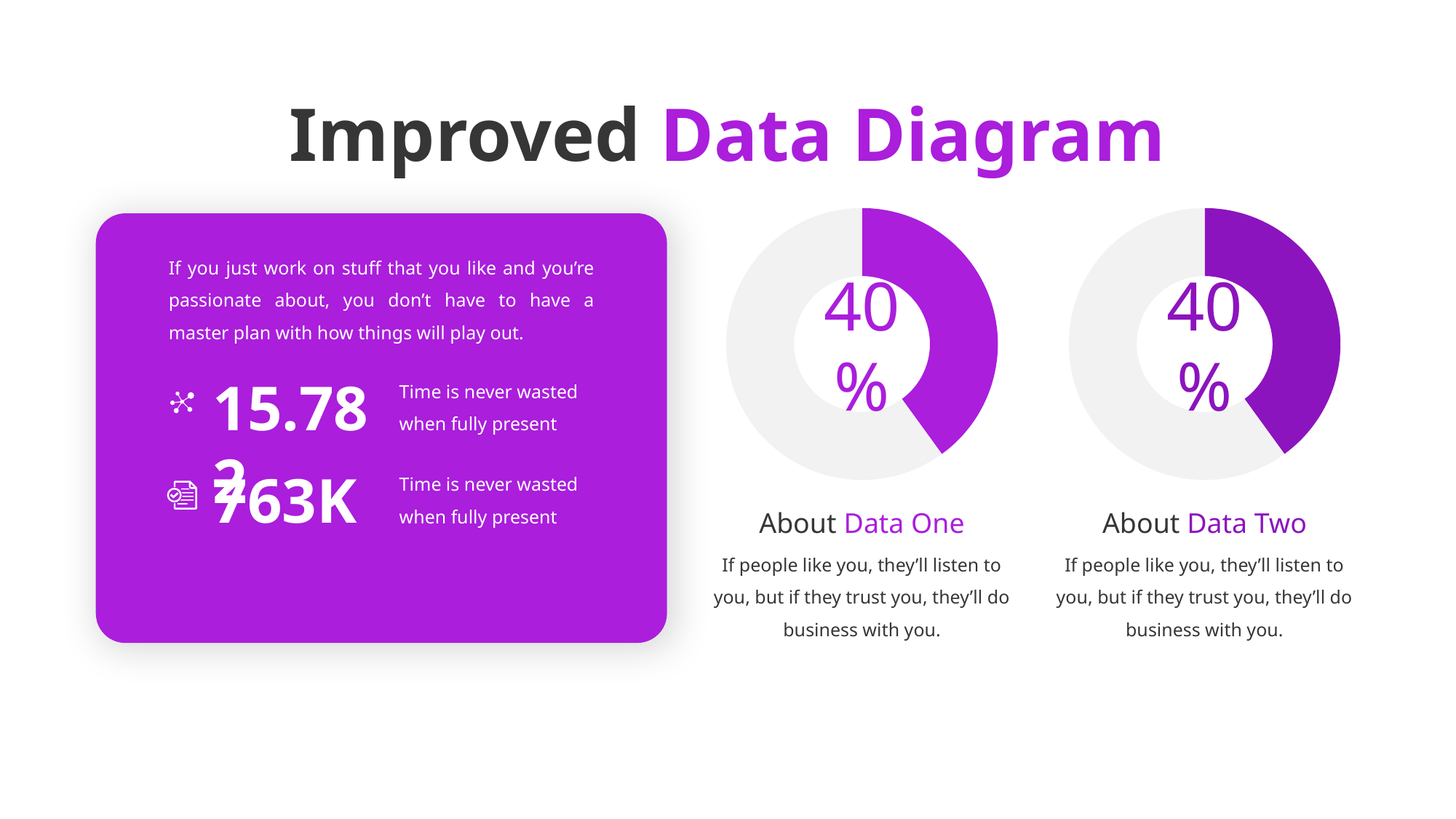
How many donut charts are shown on the slide? 2 What share of the 'About Data Two' donut is filled with purple? 40% What colour is the filled portion of the 'About Data One' donut chart? Purple What kind of chart is used for 'About Data One'? Donut (pie) chart What is the title of the slide containing the donut charts? Improved Data Diagram Is the value shown for 'About Data One' larger than, smaller than, or equal to the value for 'About Data Two'? Equal What value is shown in the centre of the 'About Data Two' donut chart? 40% What kind of chart is used for 'About Data Two'? Donut (pie) chart What value is shown in the centre of the 'About Data One' donut chart? 40% What share of the 'About Data One' donut is filled with purple? 40%